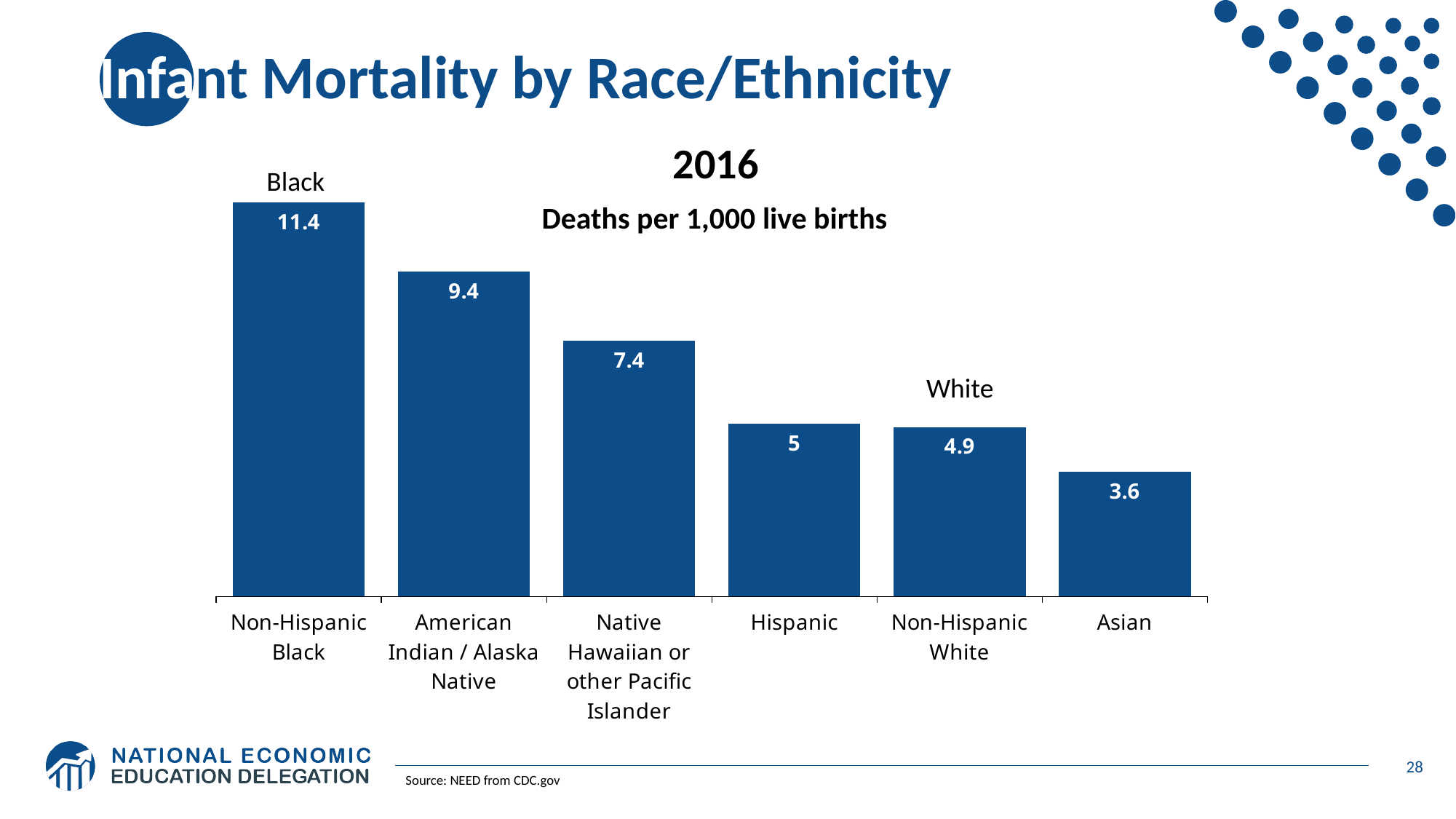
How many race/ethnicity categories are shown in the chart? 6 What unit is the infant mortality rate measured in, according to the chart subtitle? Deaths per 1,000 live births Which category has the lowest infant mortality rate? Asian What is the infant mortality rate for Hispanic? 5 What is the infant mortality rate for Asian? 3.6 Which category has the highest infant mortality rate? Non-Hispanic Black What is the difference between the infant mortality rates for Non-Hispanic Black and Non-Hispanic White? 6.5 Which has a higher infant mortality rate, American Indian / Alaska Native or Hispanic? American Indian / Alaska Native What is the infant mortality rate for Non-Hispanic Black? 11.4 What is the infant mortality rate for American Indian / Alaska Native? 9.4 What kind of chart is shown on the slide? Bar chart What is the infant mortality rate for Native Hawaiian or other Pacific Islander? 7.4